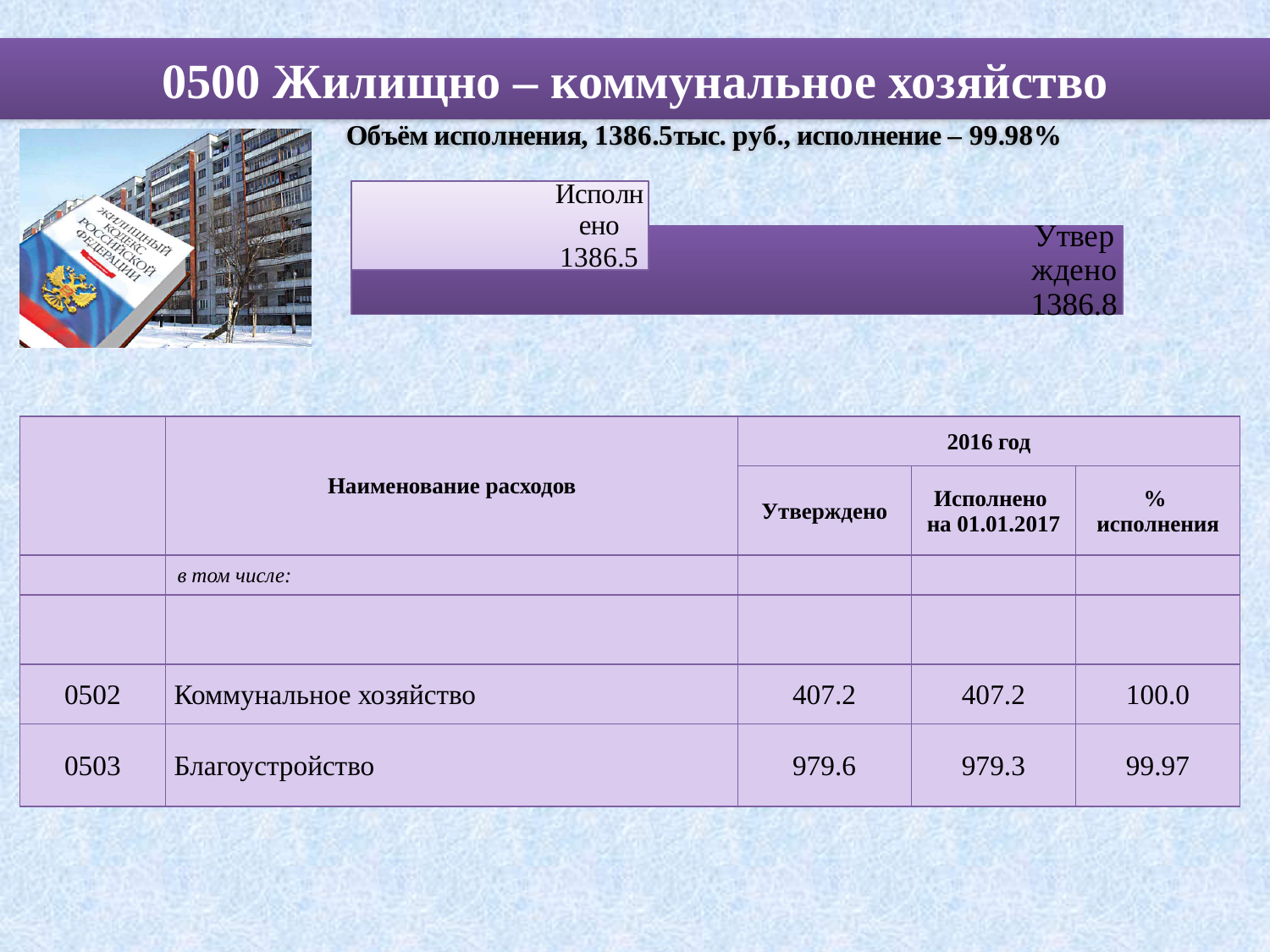
Are the bars in the chart horizontal or vertical? horizontal What is the value of the Исполнено bar in the chart? 1386.5 How many bars are plotted in the chart? 2 Which bar in the chart is drawn in the darker purple colour? Утверждено What type of chart is shown on the slide? bar chart Which bar in the chart has the higher value, Исполнено or Утверждено? Утверждено Which bar in the chart has the highest value? Утверждено Which bar in the chart has the lowest value? Исполнено What is the difference between the Утверждено and Исполнено values in the chart? 0.3 What is the value of the Утверждено bar in the chart? 1386.8